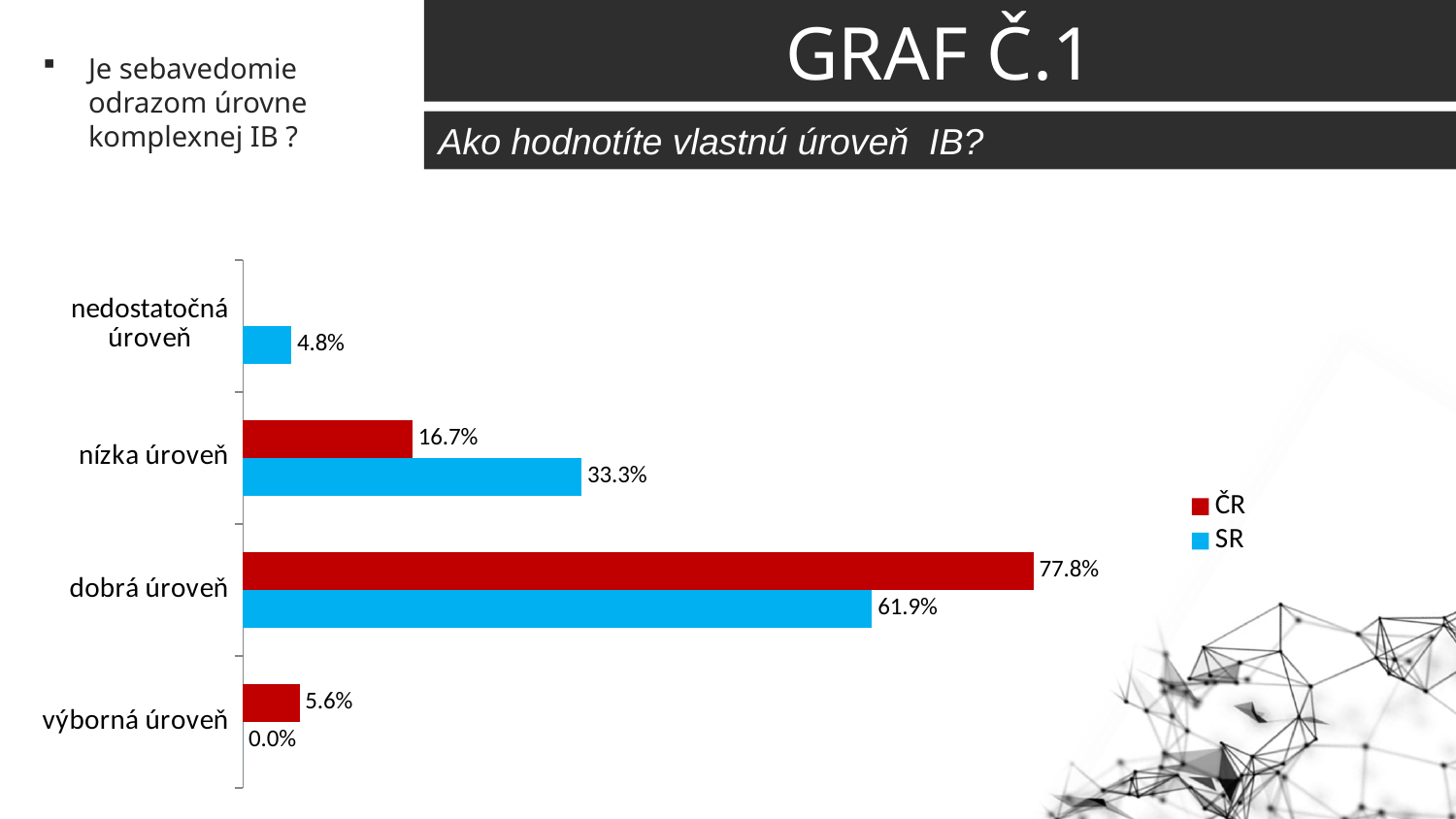
For 'nízka úroveň', which series has the larger value, ČR or SR? SR Which category has the highest ČR value? dobrá úroveň What is the SR value for 'výborná úroveň'? 0.0% What is the ČR value for 'nízka úroveň'? 16.7% What kind of chart is shown on the slide? bar chart What is the difference between the ČR and SR values for 'dobrá úroveň'? 15.9% What is the ČR value for 'dobrá úroveň'? 77.8% What colour represents the SR series in the chart? blue How many series does the legend list? 2 Which category has the lowest SR value? výborná úroveň What is the SR value for 'nedostatočná úroveň'? 4.8% What is the SR value for 'nízka úroveň'? 33.3%